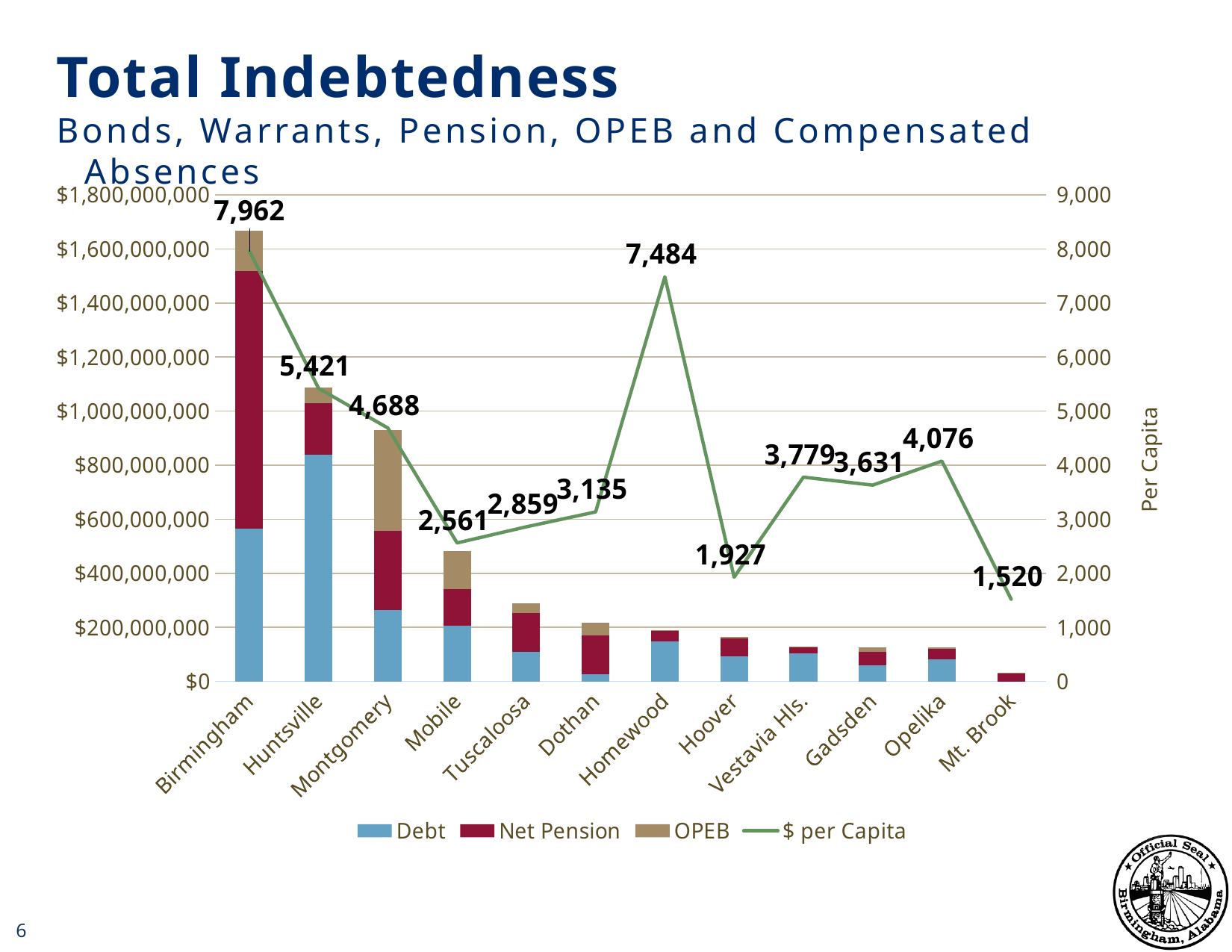
Which city has the highest $ per Capita value? Birmingham How many series does the legend list? 4 What is the difference between the $ per Capita values for Huntsville and Montgomery? 733 How many cities are shown on the x axis of the chart? 12 Which city has the lowest $ per Capita value? Mt. Brook What is the $ per Capita value for Mt. Brook? 1,520 What is the $ per Capita value for Opelika? 4,076 Is the total stacked bar for Montgomery greater or less than $1,000,000,000? less Is the total stacked bar for Birmingham greater or less than $1,600,000,000? greater What is the $ per Capita value for Homewood? 7,484 Which has a higher $ per Capita value, Vestavia Hls. or Gadsden? Vestavia Hls. What is the difference between the $ per Capita values for Birmingham and Homewood? 478